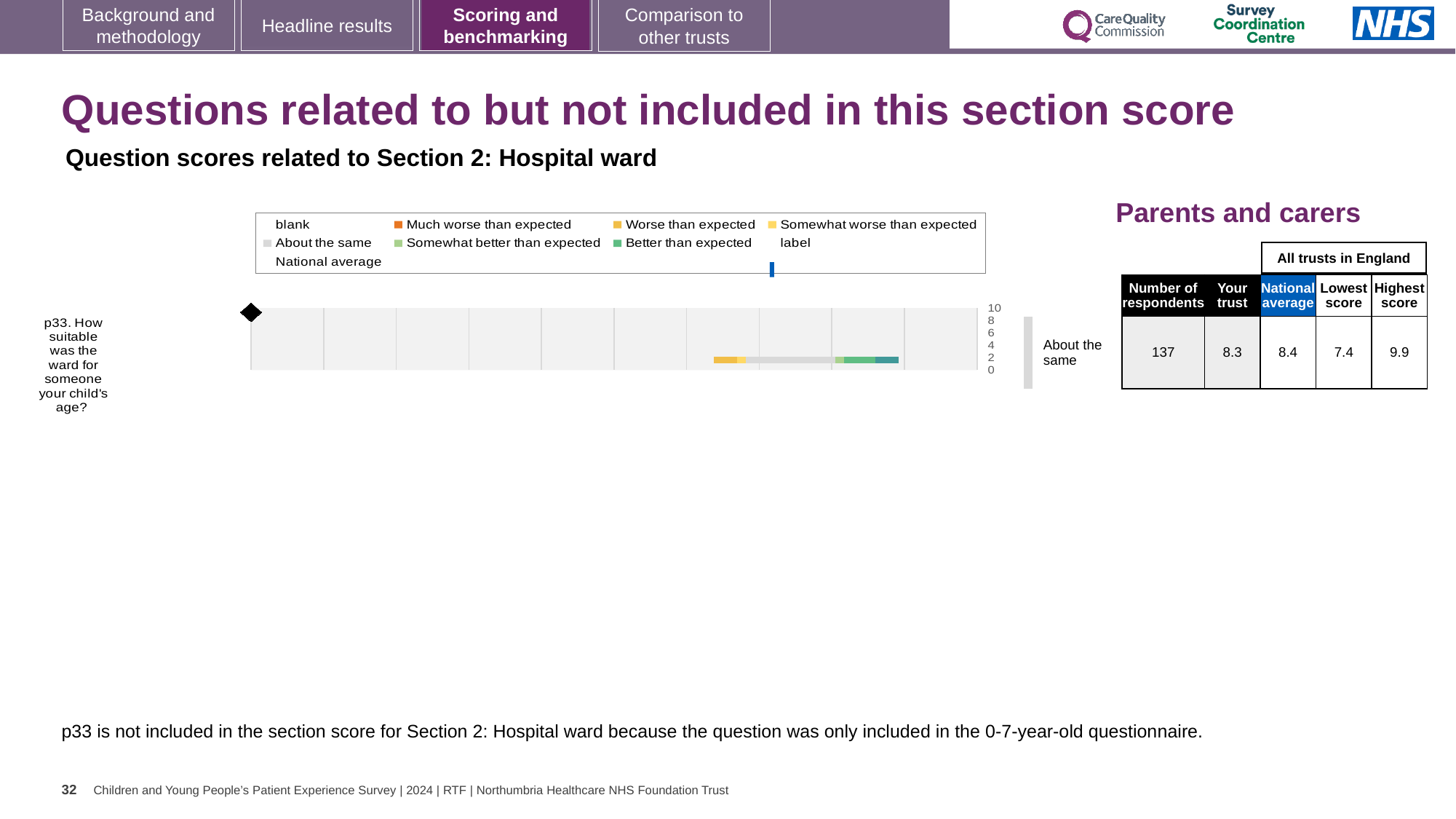
Which benchmark category is the trust's result for p33 placed in? About the same How many respondents answered p33? 137 What is the highest score among all trusts in England for p33? 9.9 What is the difference between the national average and the trust's score for p33? 0.1 What is the lowest score among all trusts in England for p33? 7.4 Which question is plotted in the chart? p33. How suitable was the ward for someone your child's age? What kind of chart is shown for question p33? bar chart What is the difference between the highest and lowest trust scores for p33? 2.5 How many questions are plotted in the chart? 1 What is the national average score for p33? 8.4 Which is larger for p33, the trust's score or the national average? the national average What is the 'Your trust' score for p33? 8.3